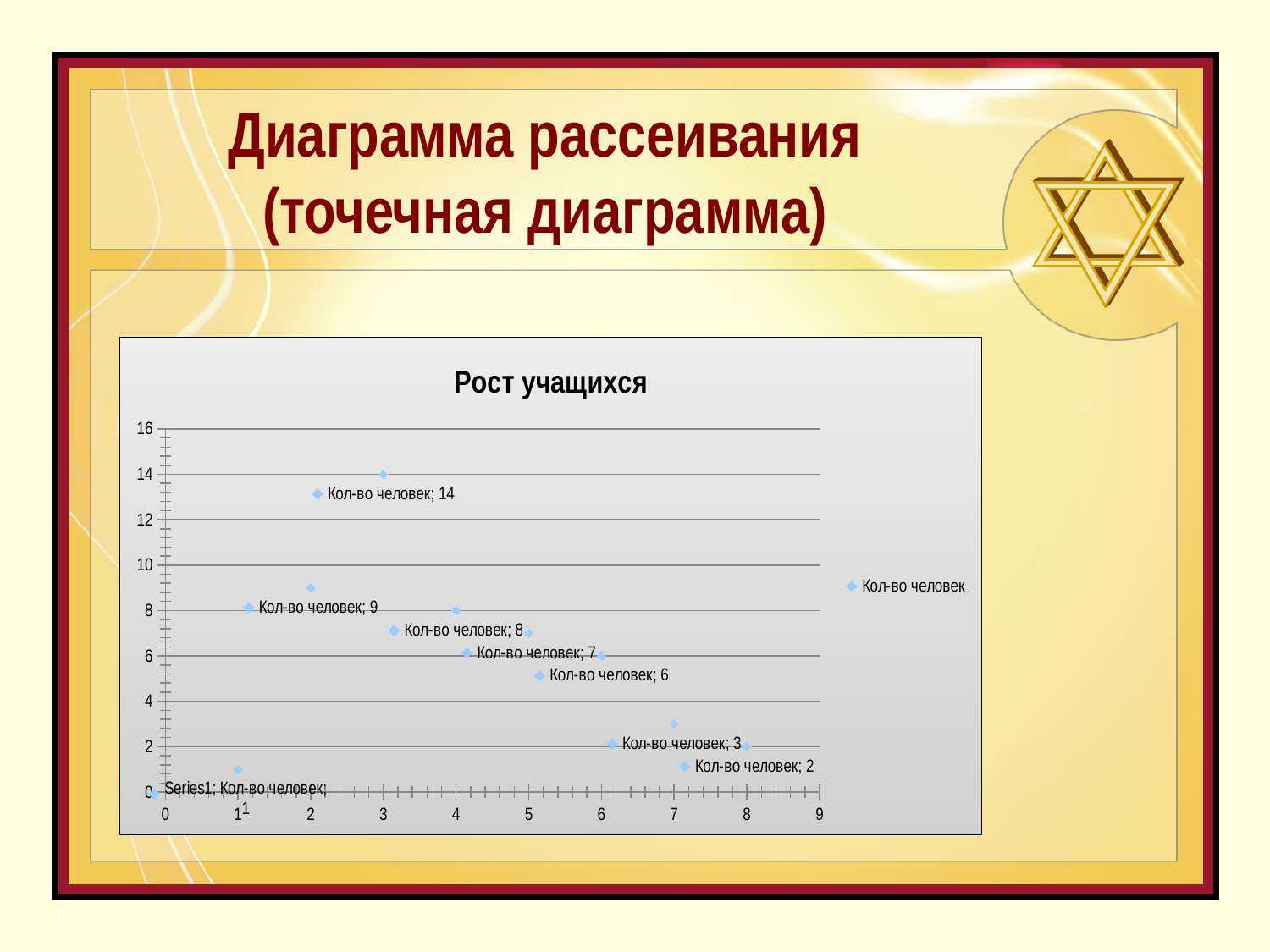
What is the title of the chart? Рост учащихся What is the name of the series shown in the legend? Кол-во человек What is the difference between the highest labelled value (14) and the labelled value 9? 5 What is the value of Кол-во человек at x = 3? 14 Do the values generally rise or fall along the x axis from x = 3 to x = 8? fall Is the value of the point at x = 3 greater or less than 12? greater What kind of chart is shown on the slide? scatter chart What is the highest labelled value of Кол-во человек on the chart? 14 Which is larger: the point labelled 'Кол-во человек; 8' or the point labelled 'Кол-во человек; 6'? Кол-во человек; 8 How many series does the chart legend list? 1 Is the value of the point at x = 8 greater or less than 4? less What is the lowest labelled non-zero value of Кол-во человек on the chart? 2